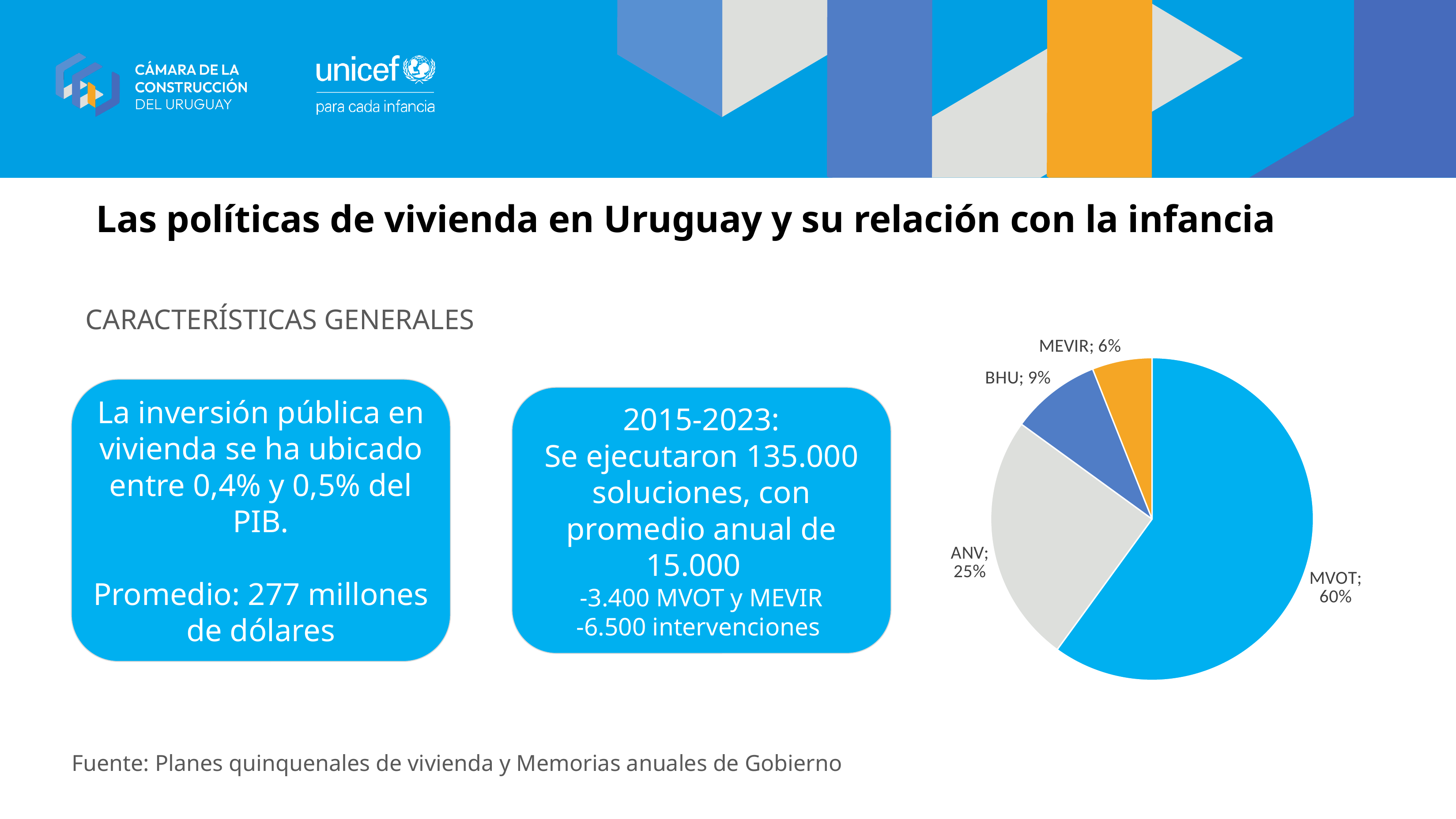
What kind of chart is shown on the slide? pie chart How many slices does the pie chart have? 4 What share of the pie does BHU have? 9% What share of the pie does ANV have? 25% Which category has the largest slice of the pie? MVOT What is the difference in percentage points between the MVOT and ANV slices? 35 What share of the pie does MVOT have? 60% What colour is the MEVIR slice of the pie? orange What is the combined share of the BHU and MEVIR slices? 15% Which slice is larger, BHU or MEVIR? BHU Which category has the smallest slice of the pie? MEVIR